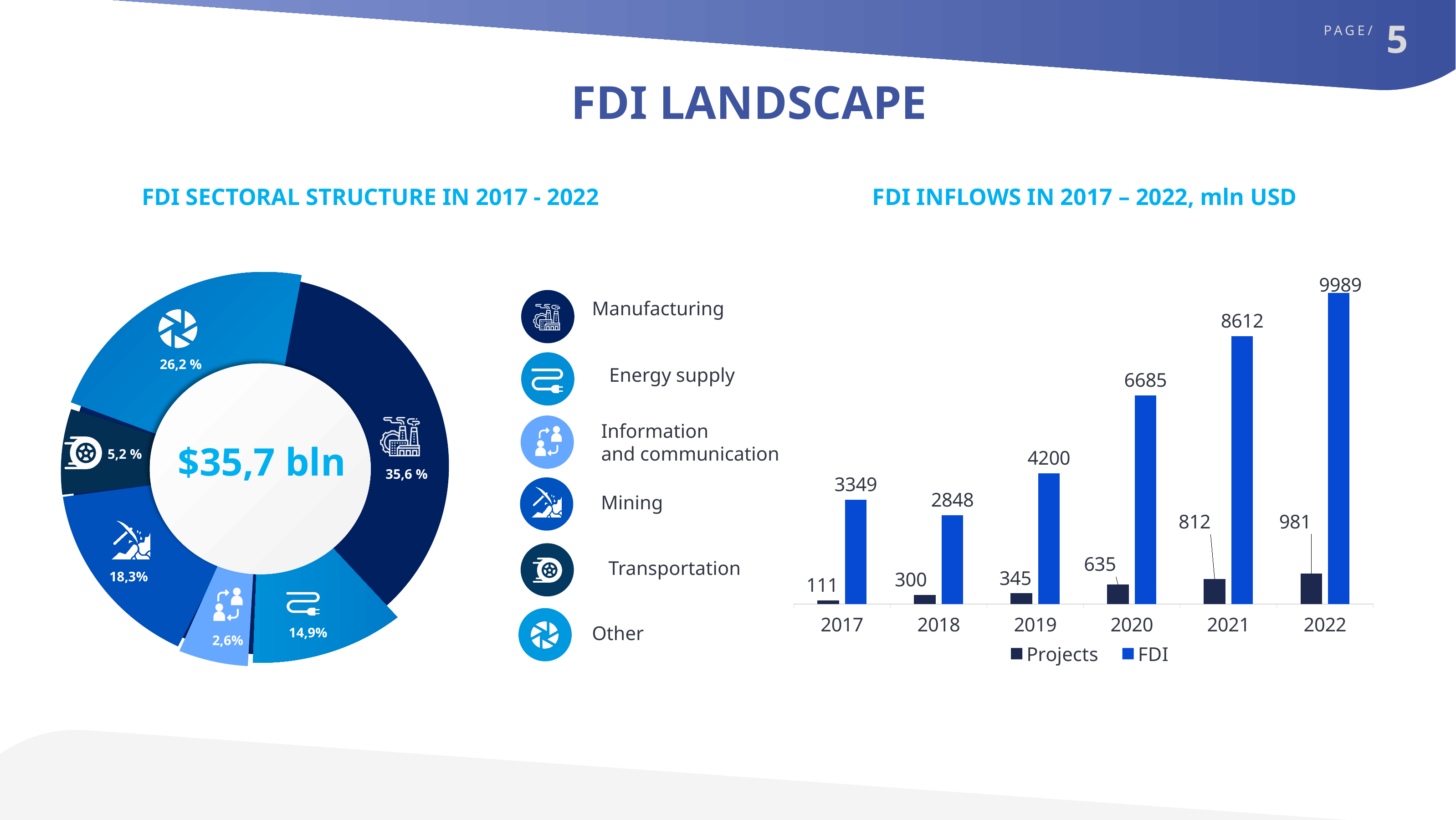
In the FDI SECTORAL STRUCTURE IN 2017 - 2022 chart, what share does Manufacturing have? 35,6 % What kind of chart is the FDI SECTORAL STRUCTURE IN 2017 - 2022 chart? donut chart In the FDI INFLOWS IN 2017 – 2022 chart, which year has the lowest FDI value? 2018 In the FDI INFLOWS IN 2017 – 2022 chart, which year has the highest Projects value? 2022 In the FDI INFLOWS IN 2017 – 2022 chart, what is the difference between the FDI values for 2021 and 2020? 1927 In the FDI INFLOWS IN 2017 – 2022 chart, how many series does the legend list? 2 In the FDI INFLOWS IN 2017 – 2022 chart, what is the FDI value for 2022? 9989 In the FDI INFLOWS IN 2017 – 2022 chart, is the FDI value for 2017 or 2018 larger? 2017 In the FDI INFLOWS IN 2017 – 2022 chart, do the Projects values rise or fall from 2017 to 2022? rise In the FDI INFLOWS IN 2017 – 2022 chart, what is the Projects value for 2019? 345 In the FDI INFLOWS IN 2017 – 2022 chart, how many years are shown on the x axis? 6 In the FDI SECTORAL STRUCTURE IN 2017 - 2022 chart, which sector has the smallest share? Information and communication